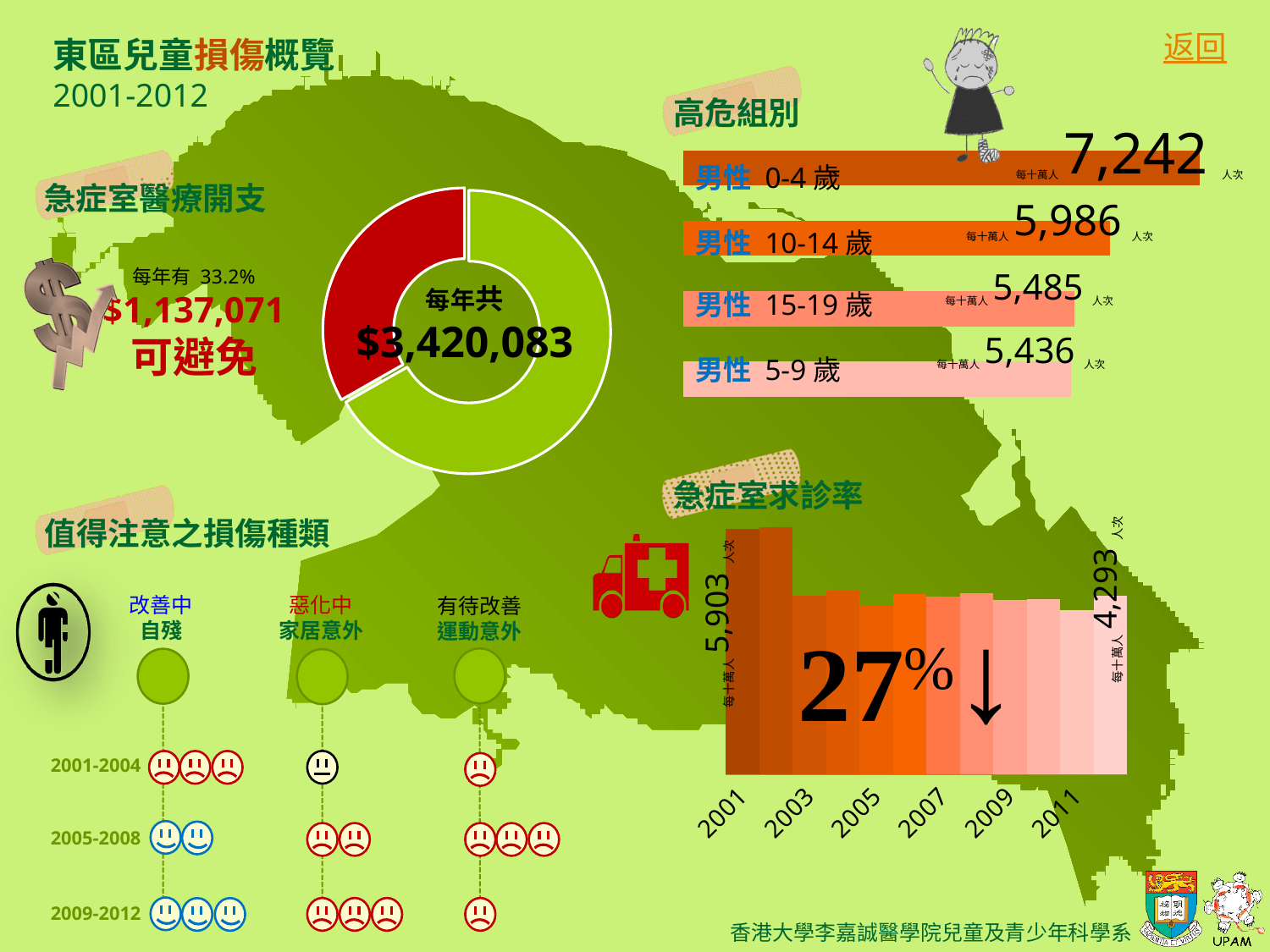
In the 急症室求診率 chart, what is the difference between the first value (5,903) and the last value (4,293)? 1,610 In the 高危組別 bar chart, what is the difference between the values for 男性 0-4 歲 and 男性 10-14 歲? 1,256 In the 高危組別 bar chart, what is the value for 男性 0-4 歲? 7,242 In the 高危組別 bar chart, which is larger: the value for 男性 15-19 歲 or 男性 5-9 歲? 男性 15-19 歲 In the 急症室求診率 chart, do the values rise or fall from 2001 to 2012? fall In the 高危組別 bar chart, how many groups are shown? 4 In the 高危組別 bar chart, which group has the lowest value? 男性 5-9 歲 In the 急症室醫療開支 donut chart, what is the annual total shown in the centre? $3,420,083 In the 高危組別 bar chart, what is the value for 男性 10-14 歲? 5,986 In the 急症室求診率 chart, what is the value for 2001? 5,903 In the 急症室醫療開支 donut chart, what share of the annual total is marked as avoidable (可避免)? 33.2% In the 高危組別 bar chart, which group has the highest value? 男性 0-4 歲